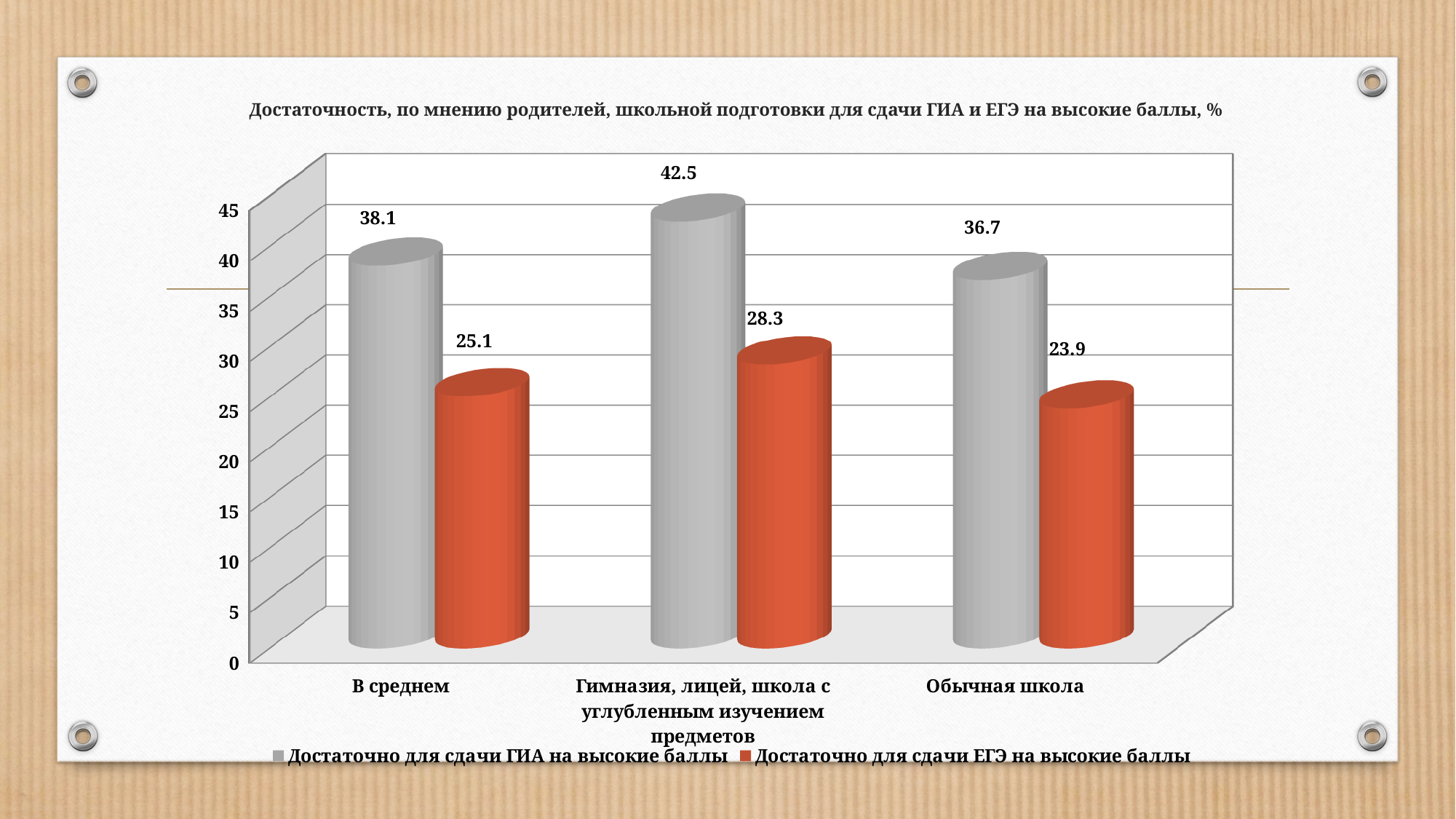
What is the value for 'Достаточно для сдачи ГИА на высокие баллы' in the 'В среднем' category? 38.1 Which category has the highest value for 'Достаточно для сдачи ГИА на высокие баллы'? Гимназия, лицей, школа с углубленным изучением предметов What kind of chart is shown on the slide? Bar chart What is the value for 'Достаточно для сдачи ЕГЭ на высокие баллы' in the 'Обычная школа' category? 23.9 How many series does the legend list? 2 What is the difference between the 'Достаточно для сдачи ГИА на высокие баллы' and 'Достаточно для сдачи ЕГЭ на высокие баллы' values in the 'Обычная школа' category? 12.8 How many categories are shown on the x axis? 3 Which is larger: the 'Достаточно для сдачи ЕГЭ на высокие баллы' value for 'В среднем' or for 'Обычная школа'? В среднем What is the difference between the 'Достаточно для сдачи ГИА на высокие баллы' values for 'Гимназия, лицей, школа с углубленным изучением предметов' and 'В среднем'? 4.4 What is the title of the chart? Достаточность, по мнению родителей, школьной подготовки для сдачи ГИА и ЕГЭ на высокие баллы, % What is the value for 'Достаточно для сдачи ЕГЭ на высокие баллы' in the 'Гимназия, лицей, школа с углубленным изучением предметов' category? 28.3 Which category has the lowest value for 'Достаточно для сдачи ЕГЭ на высокие баллы'? Обычная школа